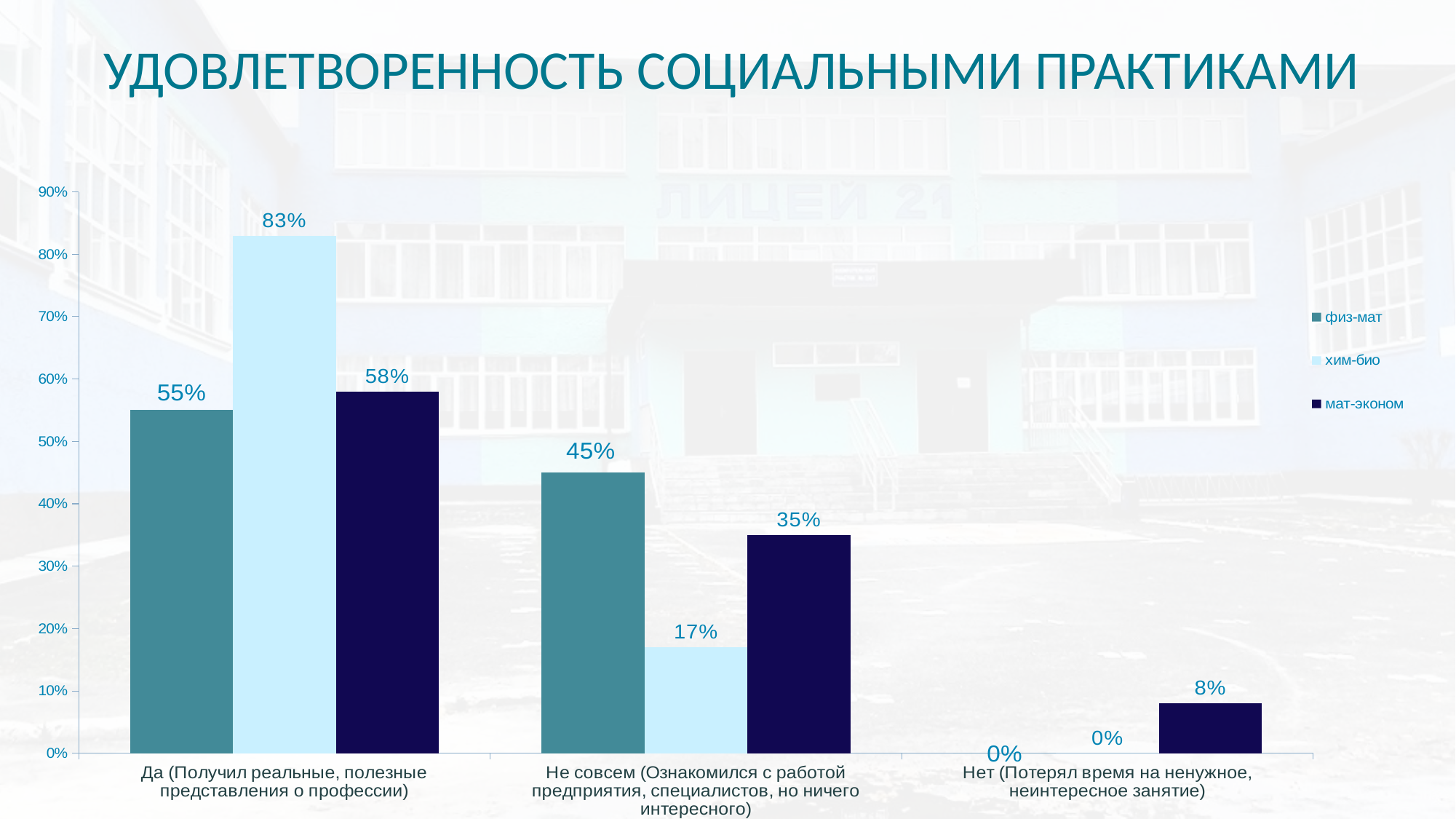
What is the value for физ-мат in the category "Не совсем (Ознакомился с работой предприятия, специалистов, но ничего интересного)"? 45% How many series does the legend list? 3 What is the value for мат-эконом in the category "Нет (Потерял время на ненужное, неинтересное занятие)"? 8% What kind of chart is shown on the slide? bar chart Is the value for физ-мат in the category "Да (Получил реальные, полезные представления о профессии)" greater or less than 50%? greater Which is larger: the мат-эконом value for "Да" or the мат-эконом value for "Не совсем"? Да Which series has the lowest value in the category "Не совсем (Ознакомился с работой предприятия, специалистов, но ничего интересного)"? хим-био Which series has the highest value in the category "Да (Получил реальные, полезные представления о профессии)"? хим-био What is the difference between the хим-био and физ-мат values in the category "Да (Получил реальные, полезные представления о профессии)"? 28% How many categories are shown on the x axis? 3 What is the value for хим-био in the category "Да (Получил реальные, полезные представления о профессии)"? 83% What is the title of the chart on the slide? УДОВЛЕТВОРЕННОСТЬ СОЦИАЛЬНЫМИ ПРАКТИКАМИ